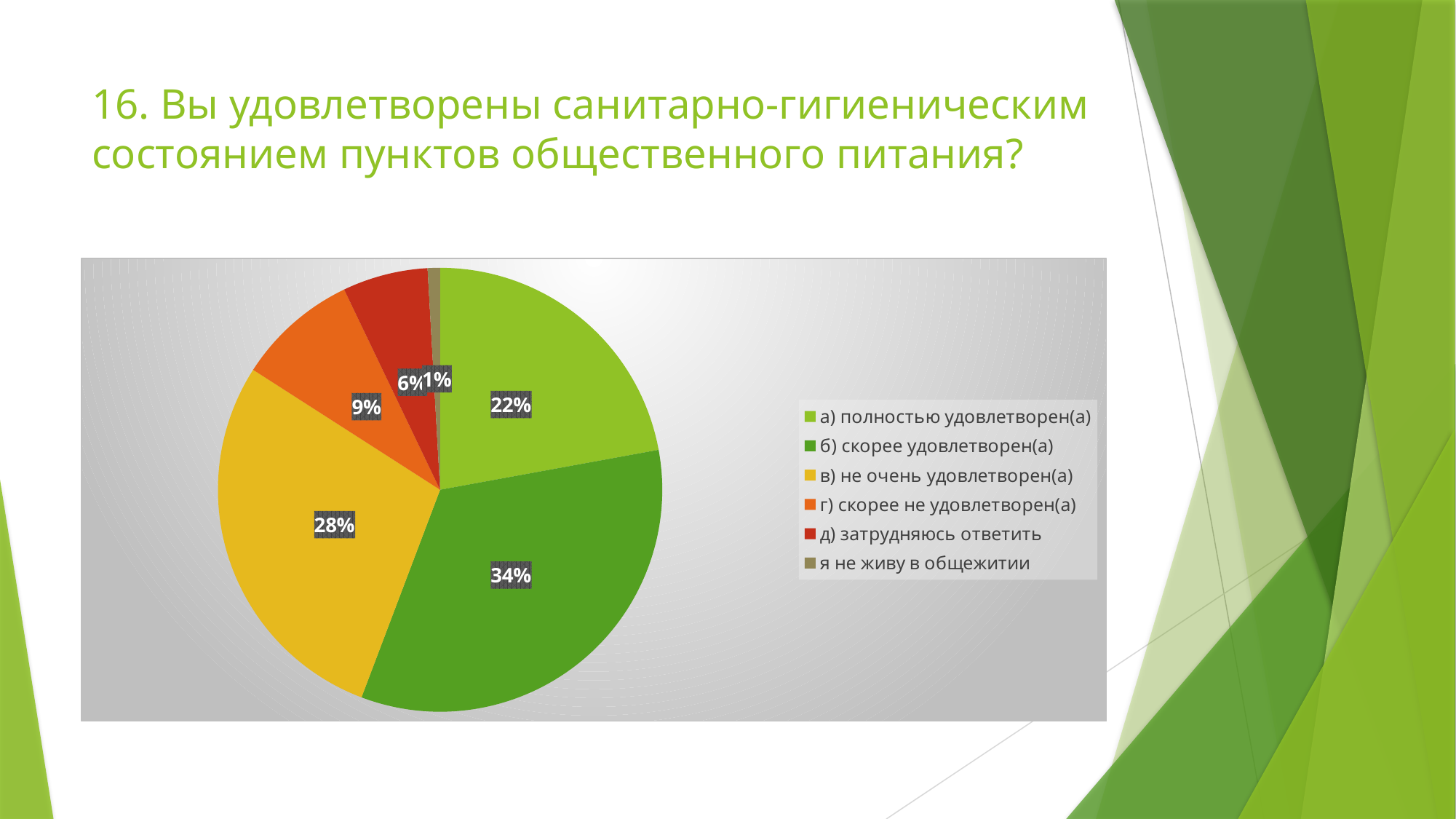
Which answer option has the smallest share of the pie? я не живу в общежитии What percentage of respondents answered "д) затрудняюсь ответить"? 6% What is the difference in percentage points between "б) скорее удовлетворен(а)" and "а) полностью удовлетворен(а)"? 12 How many answer options does the legend list? 6 What colour is the slice for "д) затрудняюсь ответить"? red What percentage of respondents answered "г) скорее не удовлетворен(а)"? 9% What percentage of respondents answered "в) не очень удовлетворен(а)"? 28% Which is larger: the share for "в) не очень удовлетворен(а)" or the share for "а) полностью удовлетворен(а)"? в) не очень удовлетворен(а) What percentage of respondents answered "б) скорее удовлетворен(а)"? 34% What percentage of respondents answered "а) полностью удовлетворен(а)"? 22% What kind of chart is shown on the slide? pie chart Which answer option has the largest share of the pie? б) скорее удовлетворен(а)